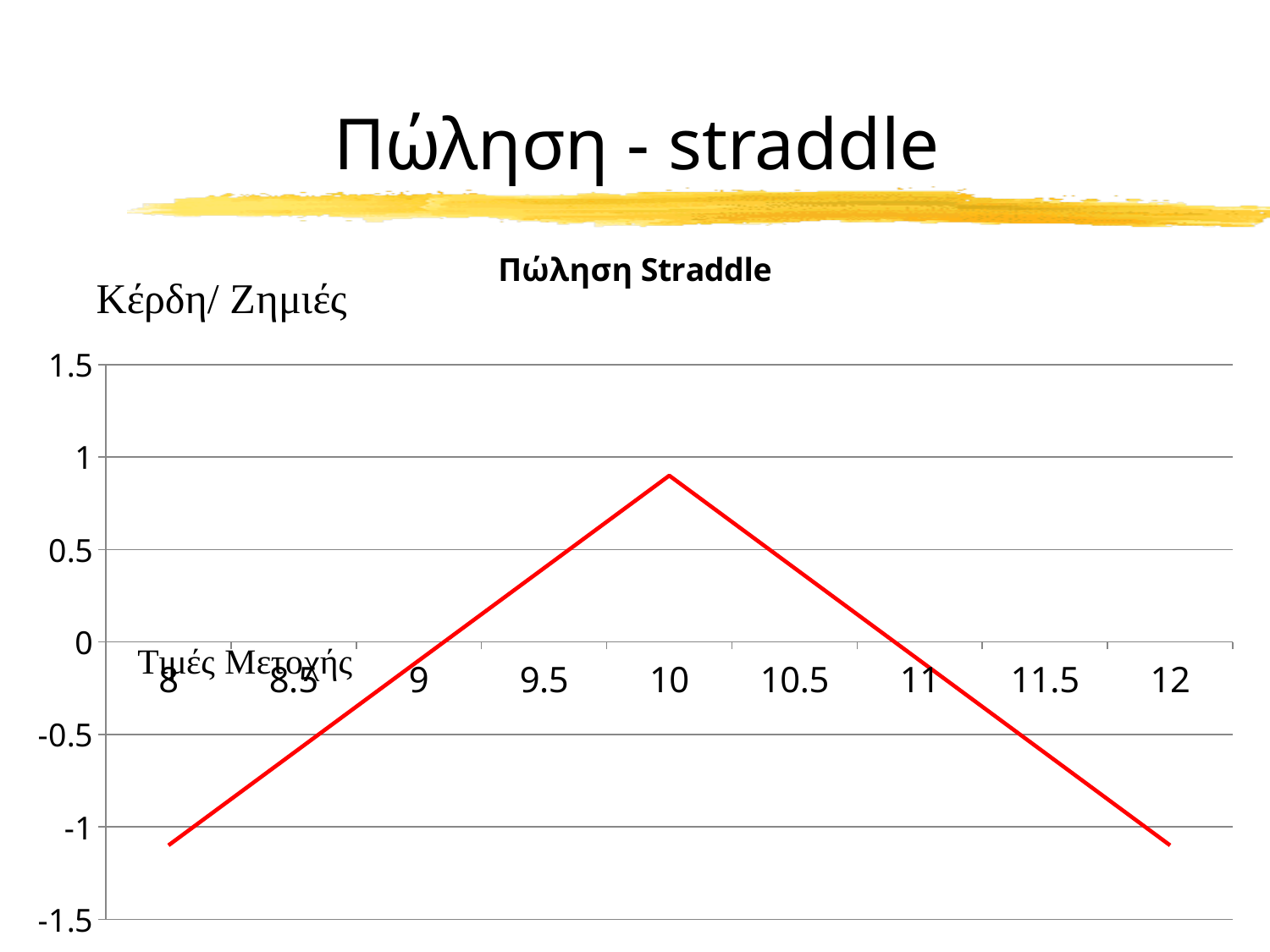
Is the value at stock price 10 greater or less than 0.5? greater How many x-axis points are plotted on the chart? 9 Do the values rise or fall as the stock price moves from 10 to 12? Fall Is the value at stock price 10 greater or less than 1? less Which is larger, the value at stock price 10 or the value at stock price 8? 10 What is the title of the chart? Πώληση Straddle What kind of chart is shown on the slide? Line chart Is the value at stock price 12 greater or less than -0.5? less Which is larger, the value at stock price 9.5 or the value at stock price 8.5? 9.5 At which stock price (Τιμές Μετοχής) does the line reach its highest value? 10 What colour is the plotted line? Red